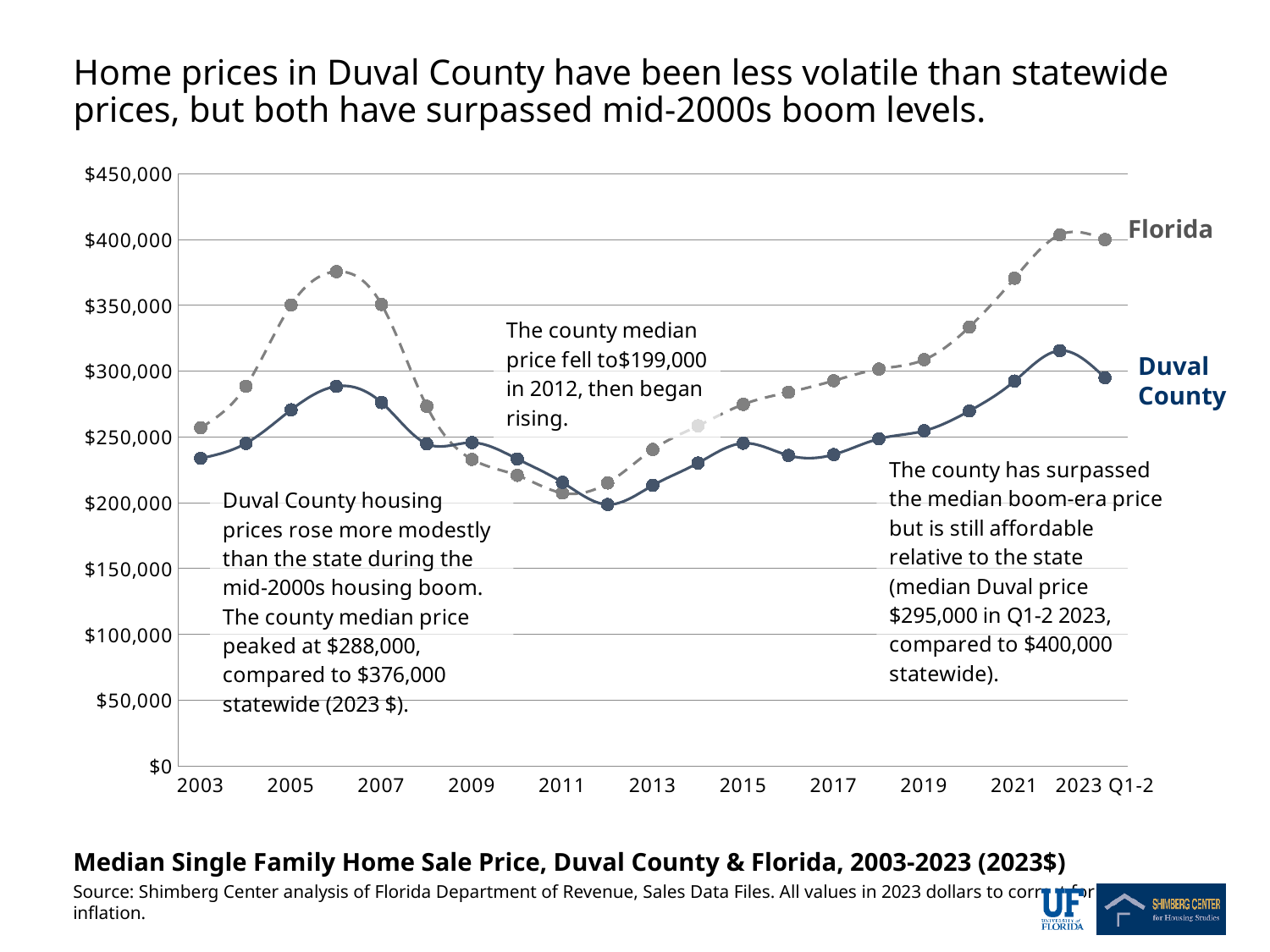
What are the names of the two series plotted on the chart? Florida and Duval County According to the slide, what was the peak Duval County median price during the mid-2000s boom? $288,000 What kind of chart is shown on the slide? Line chart What did the Duval County median price fall to in 2012? $199,000 According to the slide, what was the statewide median price at the mid-2000s peak? $376,000 Is the Florida value for 2011 greater or less than $250,000? less What is the difference between the statewide and Duval County median prices in Q1-2 2023? $105,000 What is the median Duval County price in Q1-2 2023? $295,000 In which year does the Duval County series reach its lowest value? 2012 Is the Duval County value for 2022 greater or less than $300,000? greater How many series are plotted on the chart? 2 In 2006, which series has the higher value, Florida or Duval County? Florida